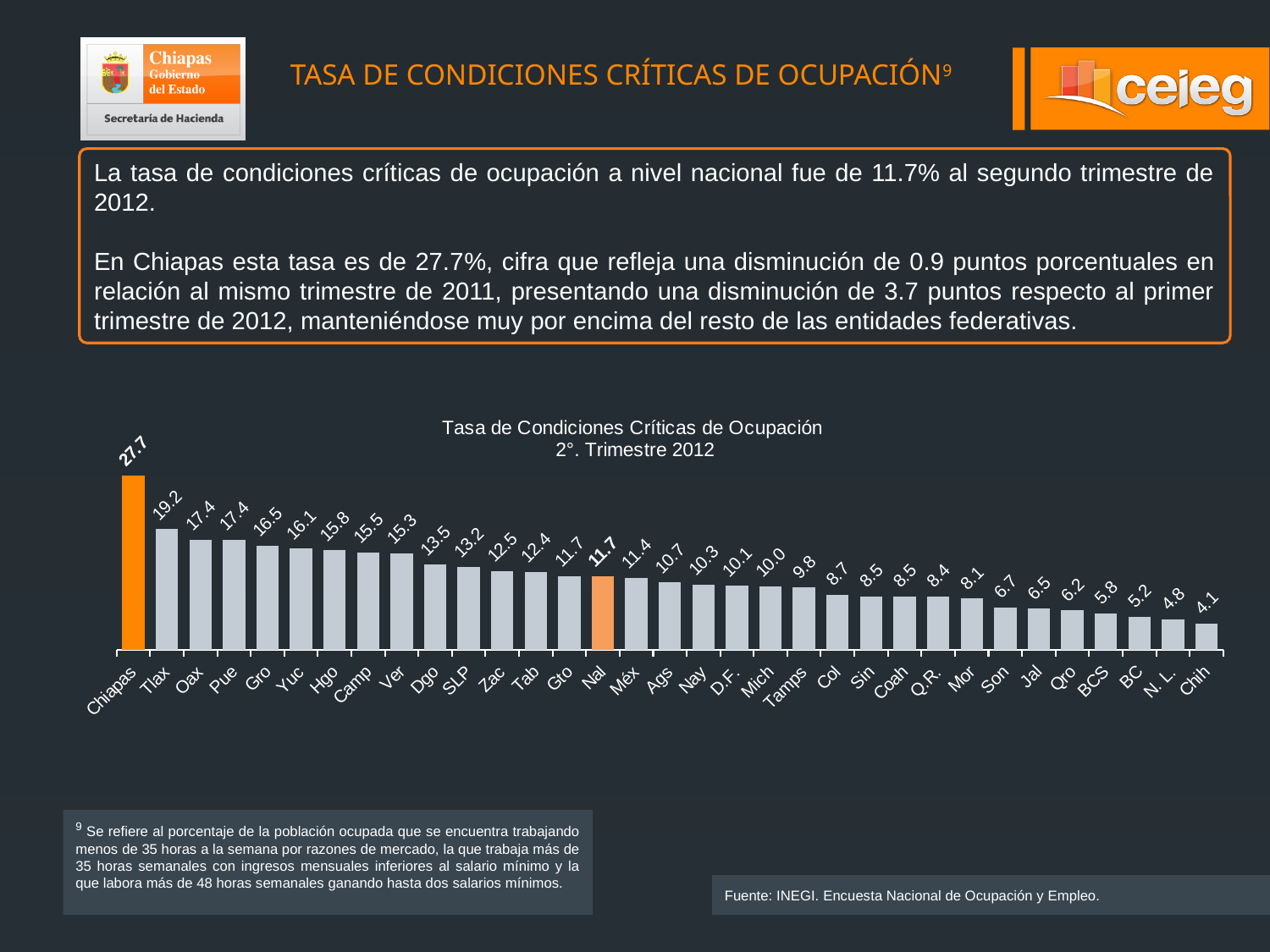
What kind of chart is shown on the slide? Bar chart How many bars are shown in the chart? 33 Do the values rise or fall from left to right along the x axis? Fall What is the difference between the values for Chiapas and Tlax? 8.5 What is the value for Chiapas? 27.7 Which has a larger value, Gro or Yuc? Gro Which category has the highest value? Chiapas What is the value for Chih? 4.1 What is the value for Nal (national)? 11.7 Which category has the lowest value? Chih What is the difference between the values for Chiapas and Nal? 16.0 What is the value for Tlax? 19.2